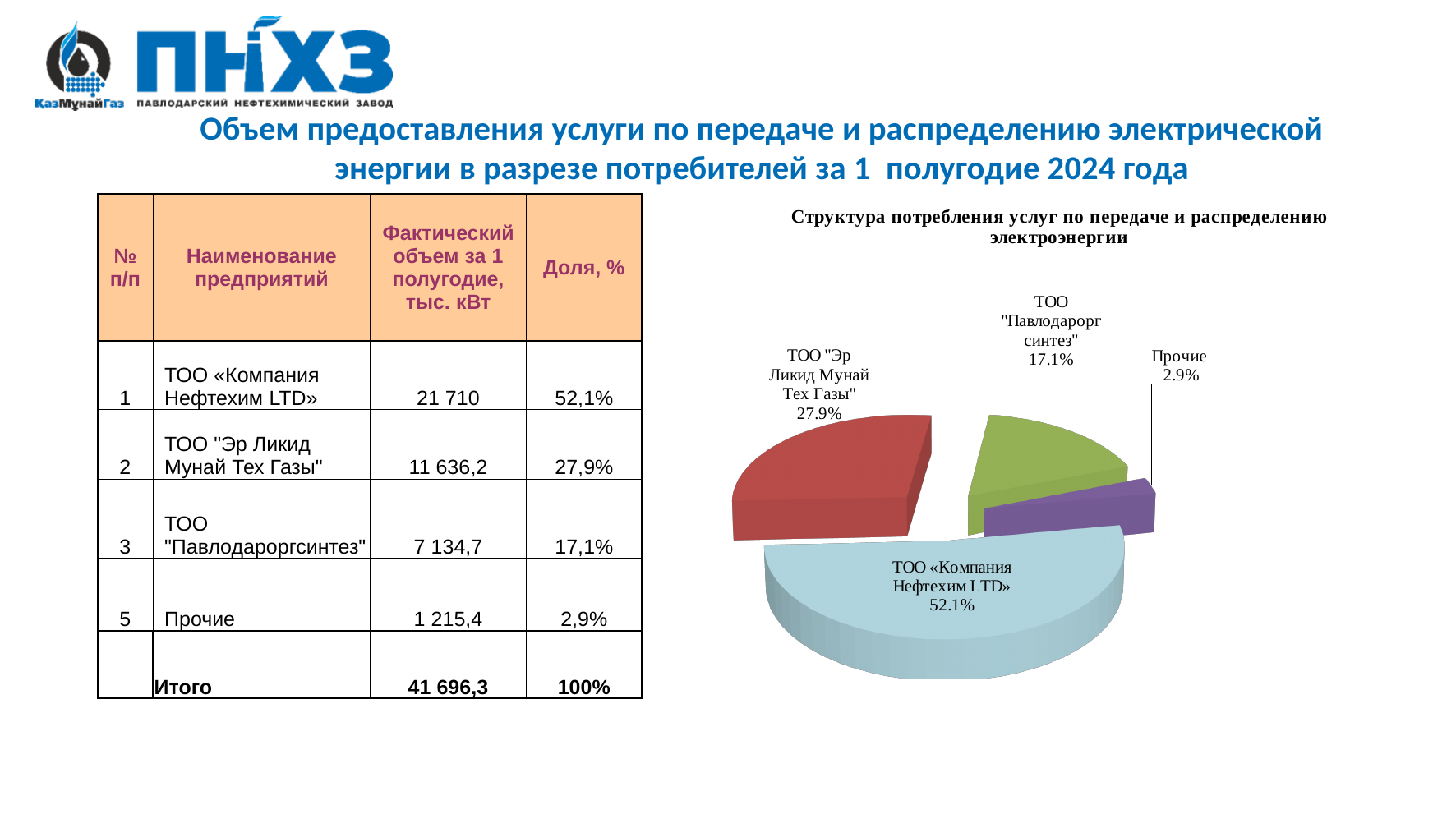
Which slice is larger: ТОО "Павлодароргсинтез" or Прочие? ТОО "Павлодароргсинтез" How many slices does the pie chart have? 4 What is the difference in percentage points between the shares of ТОО «Компания Нефтехим LTD» and ТОО "Эр Ликид Мунай Тех Газы"? 24.2 Which slice of the pie chart is the largest? ТОО «Компания Нефтехим LTD» Which slice of the pie chart is the smallest? Прочие What kind of chart is shown on the slide? Pie chart What colour is the slice for ТОО «Компания Нефтехим LTD» in the pie chart? Light blue What share of the pie does ТОО «Компания Нефтехим LTD» hold? 52.1% What share of the pie does ТОО "Павлодароргсинтез" hold? 17.1% What is the title of the pie chart? Структура потребления услуг по передаче и распределению электроэнергии What share of the pie does Прочие hold? 2.9%